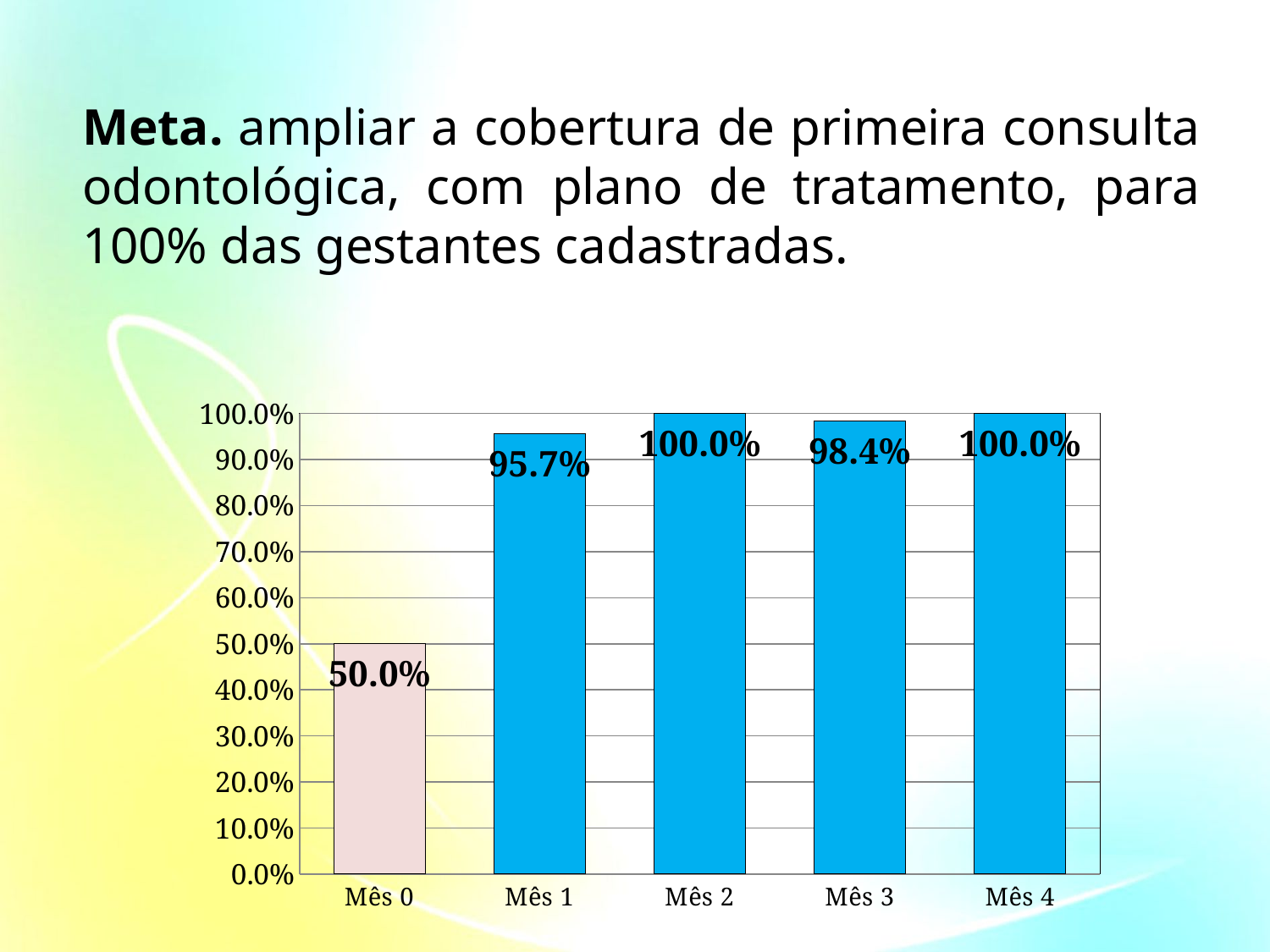
Which is larger, the value for Mês 1 or the value for Mês 3? Mês 3 What is the value for Mês 0? 50.0% Is the value for Mês 1 greater or less than 90.0%? greater Which category has the lowest value? Mês 0 What is the value for Mês 3? 98.4% What is the difference between the values for Mês 1 and Mês 0? 45.7% What is the value for Mês 1? 95.7% Which bar is shown in a different colour from the others? Mês 0 What is the difference between the values for Mês 2 and Mês 3? 1.6% What is the value for Mês 2? 100.0% What kind of chart is shown on the slide? bar chart How many categories are shown on the x axis? 5